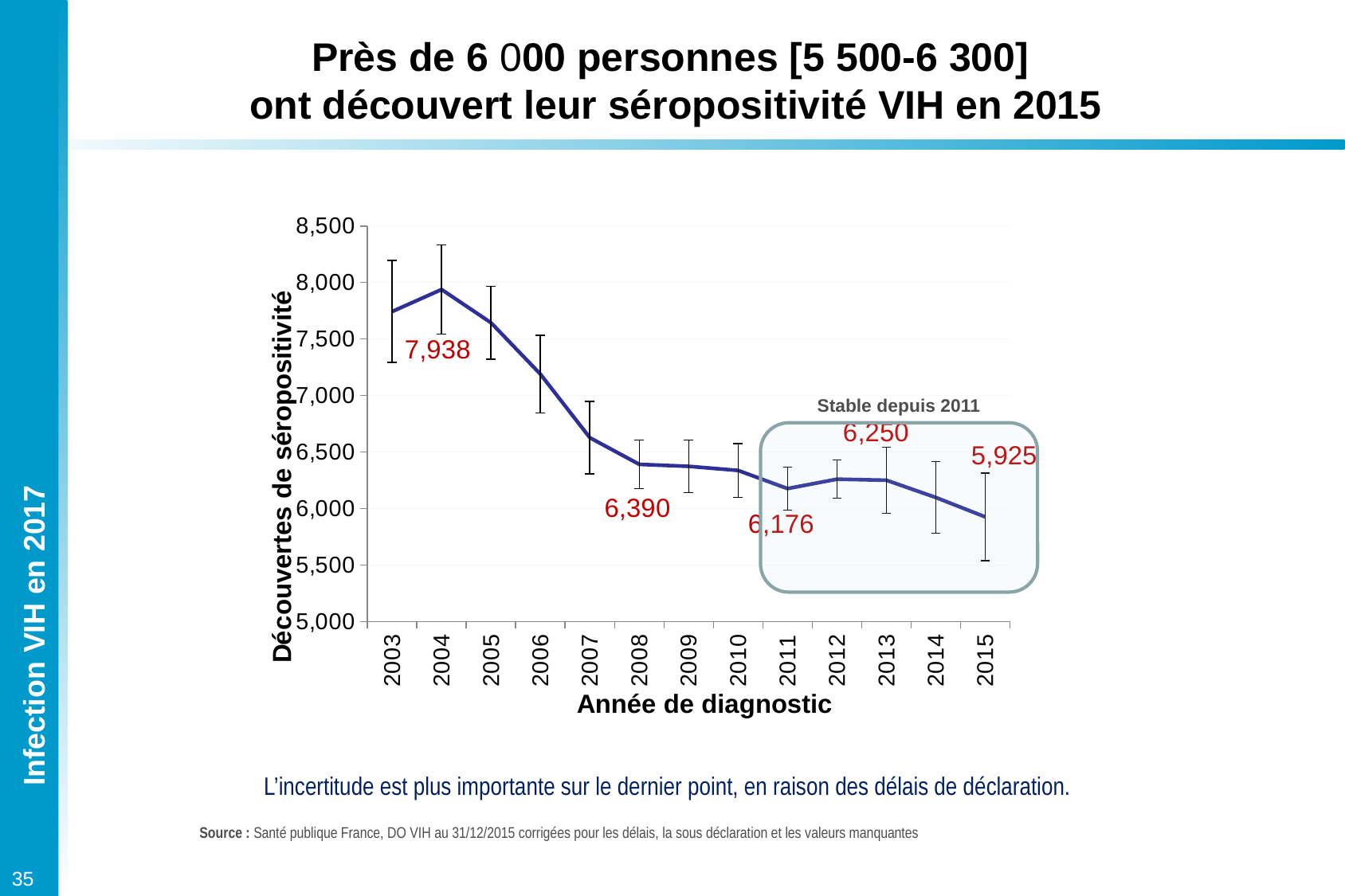
Which year has the highest value on the chart? 2004 Is the value for 2006 greater or less than 7,000? greater What is the difference between the values for 2004 and 2015? 2,013 Which year has the lowest value on the chart? 2015 What is the value plotted for 2011? 6,176 What is the title of the x axis? Année de diagnostic How many years are shown on the x axis? 13 Which is larger, the value for 2011 or the value for 2013? 2013 What is the value plotted for 2004? 7,938 What kind of chart is shown on the slide? line chart What is the value plotted for 2015? 5,925 What is the value plotted for 2008? 6,390